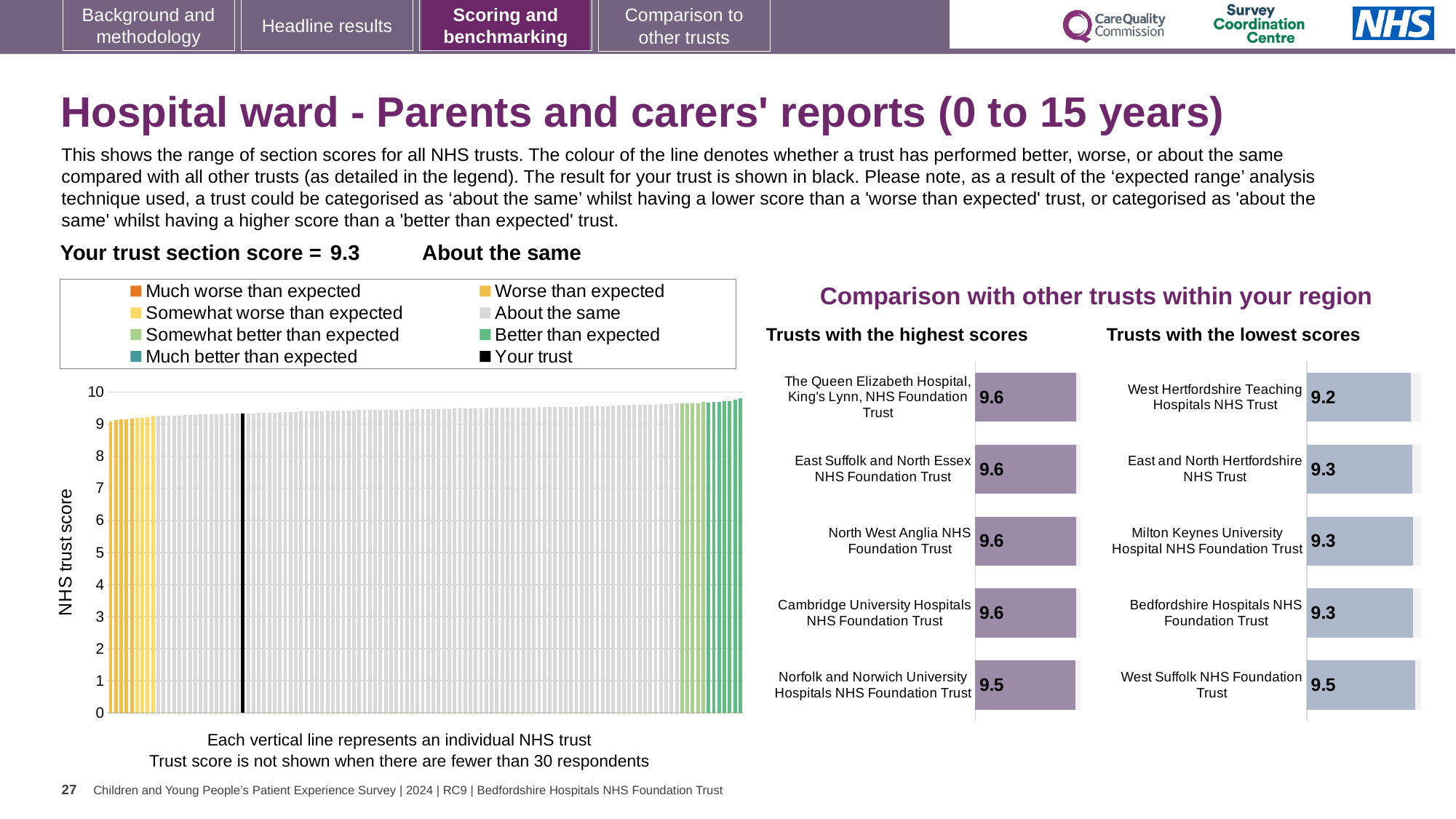
What kind of chart is the large chart on the left showing NHS trust scores? Bar chart In the 'Trusts with the lowest scores' chart, what is the difference between the score for West Suffolk NHS Foundation Trust and the score for West Hertfordshire Teaching Hospitals NHS Trust? 0.3 In the 'Trusts with the lowest scores' chart, what is the score for Bedfordshire Hospitals NHS Foundation Trust? 9.3 In the 'Trusts with the highest scores' chart, what is the score for The Queen Elizabeth Hospital, King's Lynn, NHS Foundation Trust? 9.6 In the 'Trusts with the highest scores' chart, how many trusts are shown? 5 In the 'Trusts with the lowest scores' chart, which trust has the lowest score? West Hertfordshire Teaching Hospitals NHS Trust In the 'Trusts with the highest scores' chart, what is the score for Norfolk and Norwich University Hospitals NHS Foundation Trust? 9.5 In the 'Trusts with the lowest scores' chart, which has the larger score: West Suffolk NHS Foundation Trust or East and North Hertfordshire NHS Trust? West Suffolk NHS Foundation Trust In the 'Trusts with the lowest scores' chart, what is the score for West Hertfordshire Teaching Hospitals NHS Trust? 9.2 In the 'Trusts with the lowest scores' chart, which trust has the highest score? West Suffolk NHS Foundation Trust In the 'Trusts with the highest scores' chart, what is the difference between the score for Cambridge University Hospitals NHS Foundation Trust and the score for Norfolk and Norwich University Hospitals NHS Foundation Trust? 0.1 In the 'Trusts with the highest scores' chart, which trust has the lowest score? Norfolk and Norwich University Hospitals NHS Foundation Trust